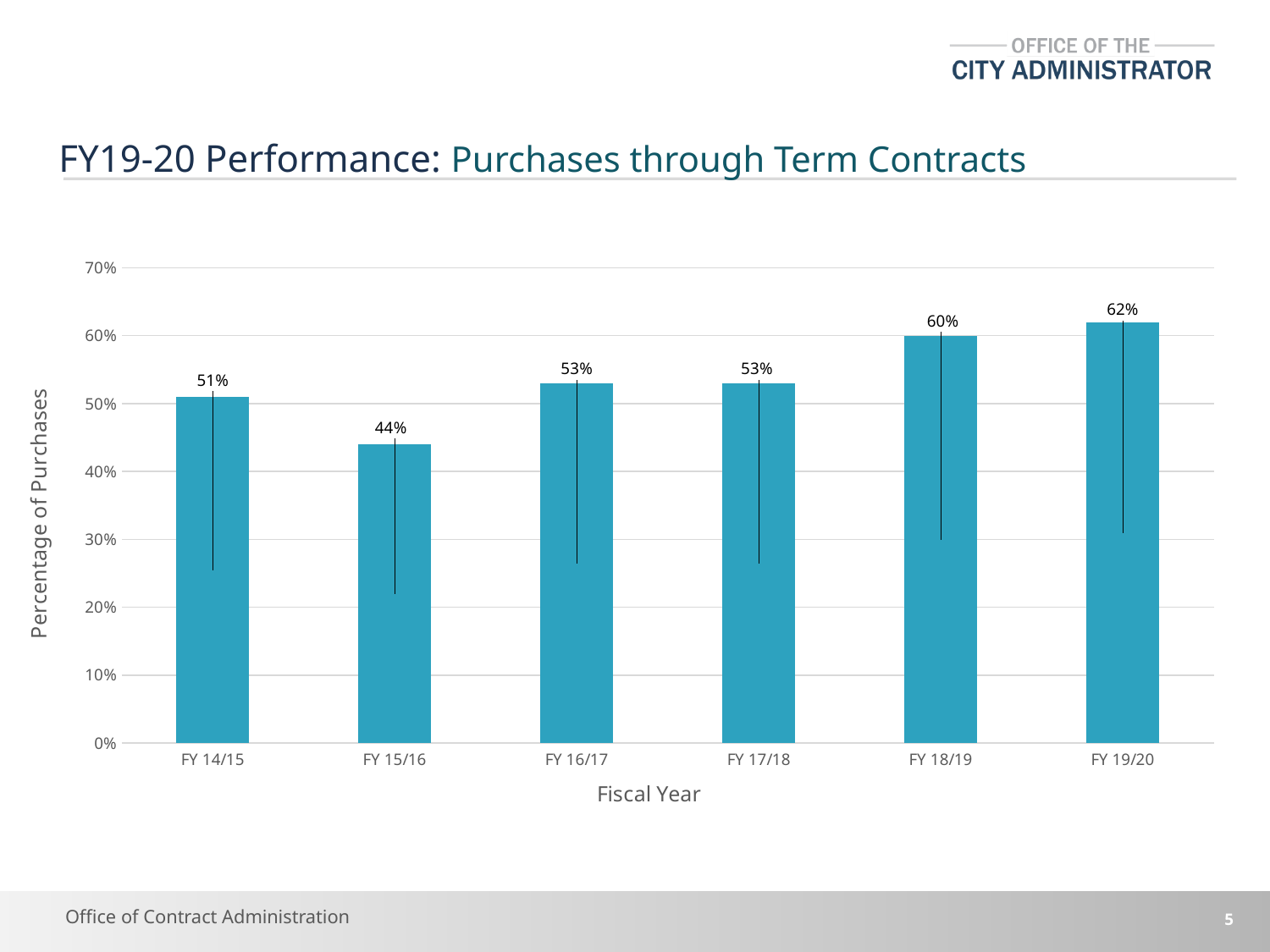
Which fiscal year has the lowest percentage of purchases through term contracts? FY 15/16 Is the value for FY 16/17 greater or less than 50%? greater What kind of chart is shown on the slide? Bar chart Which fiscal year has the highest percentage of purchases through term contracts? FY 19/20 What is the value shown for FY 15/16? 44% What is the difference in percentage points between FY 18/19 and FY 15/16? 16 What is the label of the y axis? Percentage of Purchases How many fiscal years are shown on the chart? 6 What percentage of purchases is shown for FY 19/20? 62% What percentage of purchases were made through term contracts in FY 14/15? 51% Which is larger, the value for FY 18/19 or the value for FY 17/18? FY 18/19 What is the difference in percentage points between FY 19/20 and FY 14/15? 11